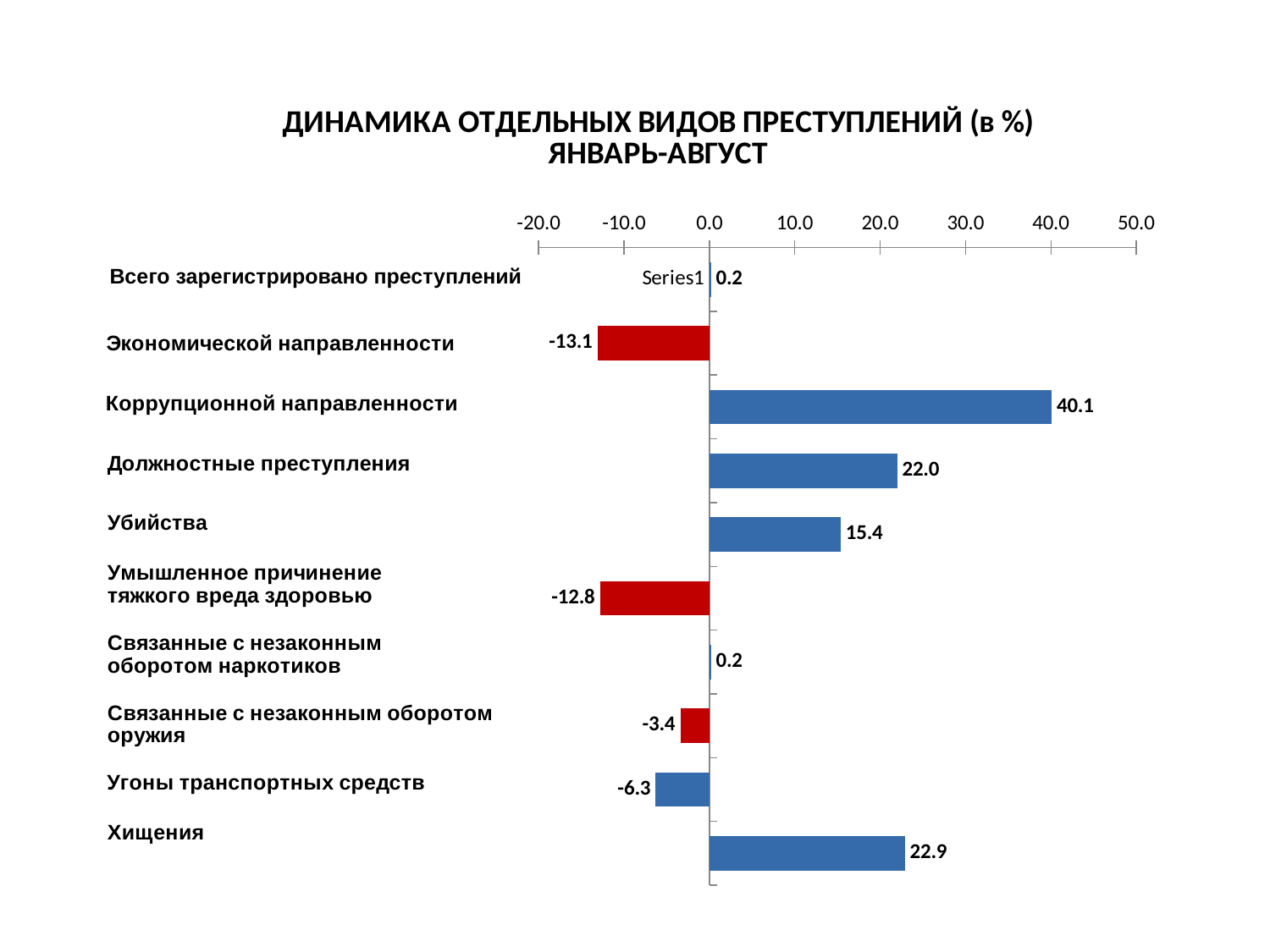
What is the difference between the values for Коррупционной направленности and Должностные преступления? 18.1 What is the value for Коррупционной направленности? 40.1 What is the value for Хищения? 22.9 What type of chart is shown on the slide? bar chart What is the value for Умышленное причинение тяжкого вреда здоровью? -12.8 How many categories are shown in the chart? 10 What is the value for Экономической направленности? -13.1 Which category has the lowest value? Экономической направленности What is the value for Угоны транспортных средств? -6.3 What is the title of the chart? ДИНАМИКА ОТДЕЛЬНЫХ ВИДОВ ПРЕСТУПЛЕНИЙ (в %) ЯНВАРЬ-АВГУСТ Which is larger, the value for Хищения or the value for Убийства? Хищения Which category has the highest value? Коррупционной направленности